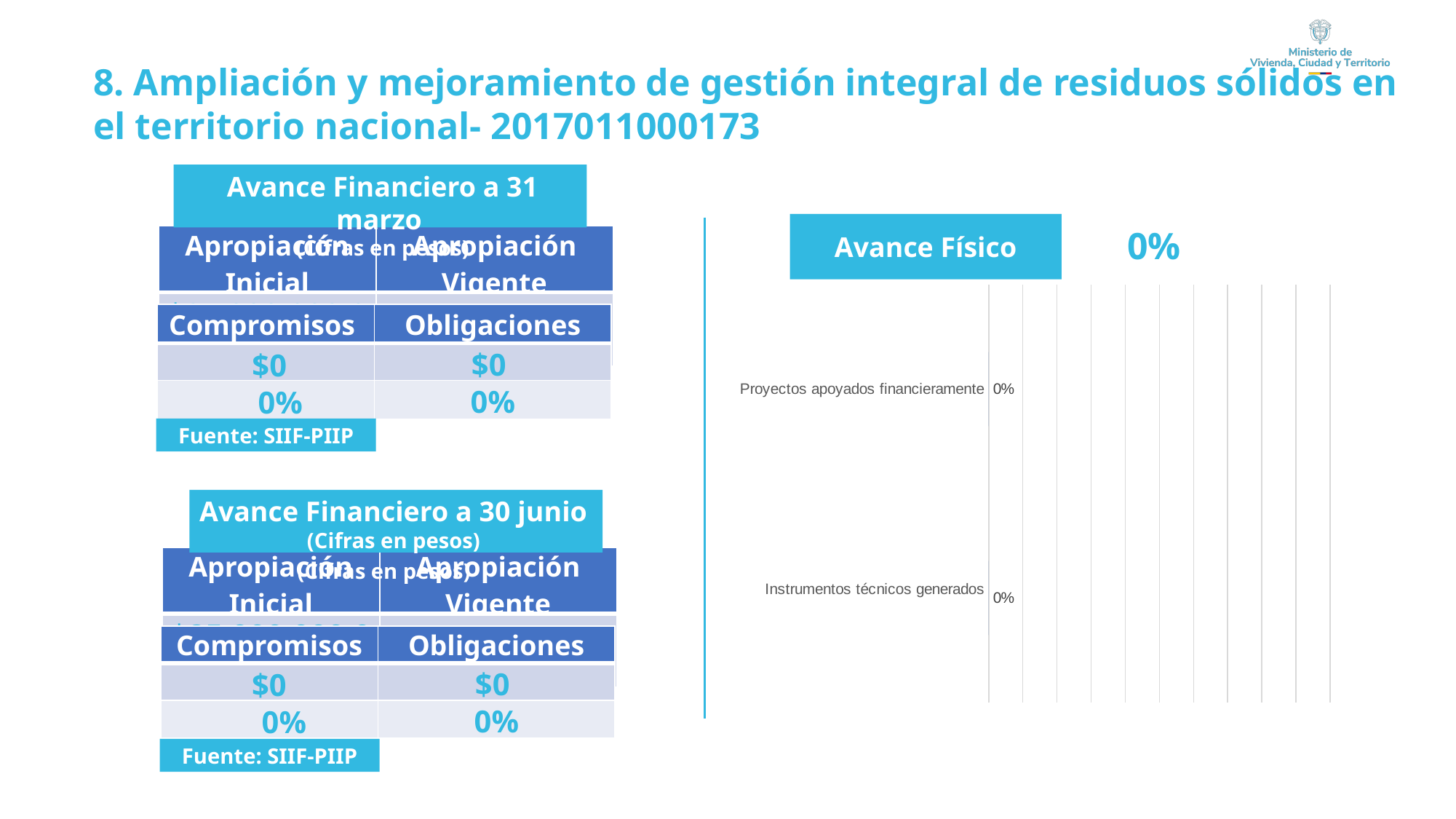
How many categories are plotted in the Avance Físico chart? 2 In the Avance Físico chart, what is the value for Proyectos apoyados financieramente? 0% What kind of chart is the Avance Físico chart? Bar chart What overall percentage is displayed next to the Avance Físico chart title? 0% What is the difference between the values for Proyectos apoyados financieramente and Instrumentos técnicos generados in the Avance Físico chart? 0% What is the title of the chart on the right side of the slide? Avance Físico In the Avance Físico chart, what is the value for Instrumentos técnicos generados? 0%